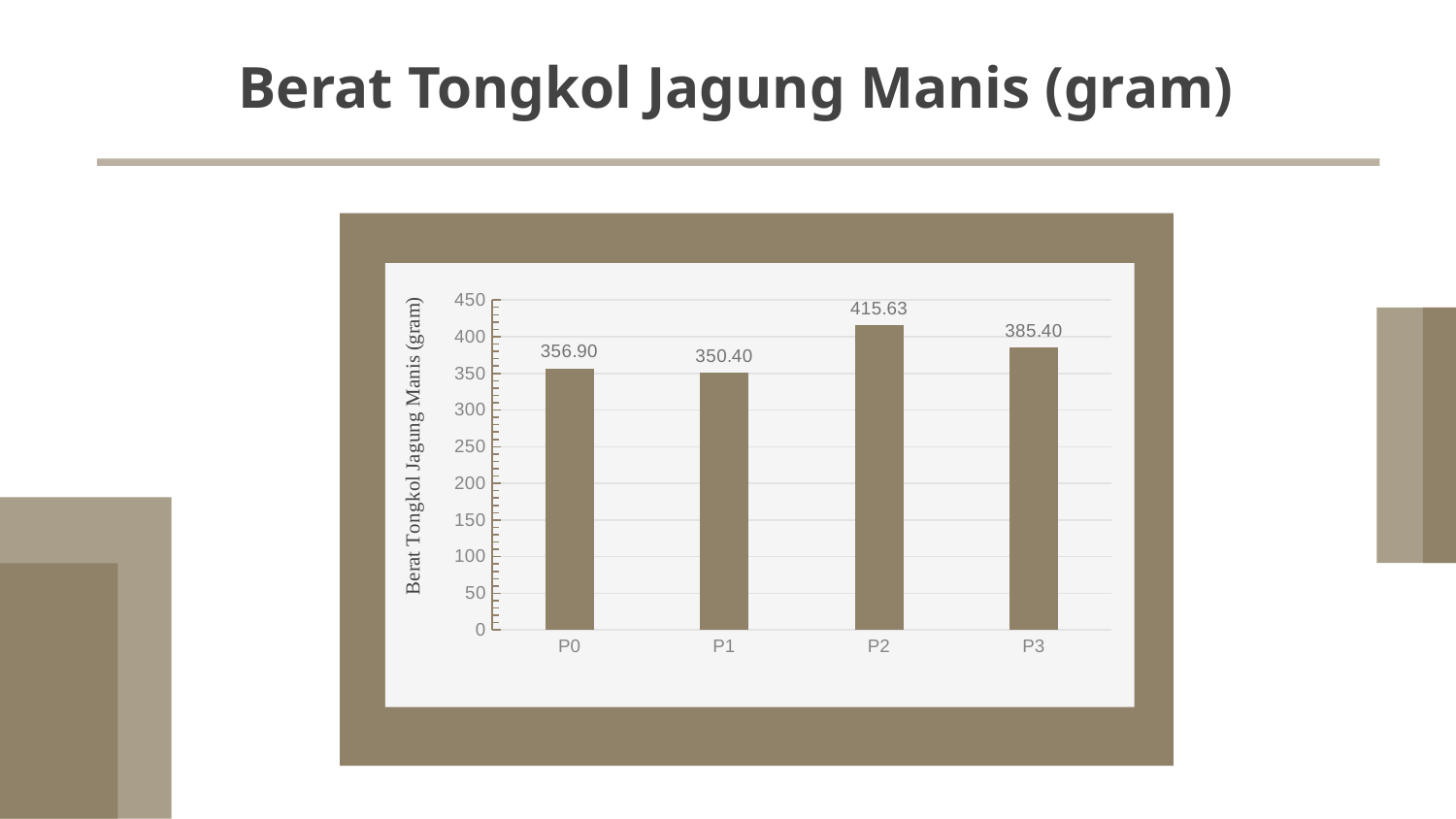
What is the value for P3? 385.40 What kind of chart is shown on the slide? bar chart What is the label of the vertical axis? Berat Tongkol Jagung Manis (gram) Which is larger, the value for P0 or the value for P3? P3 What is the value for P2? 415.63 Which category has the lowest value? P1 What is the difference between the values for P3 and P0? 28.50 Which category has the highest value? P2 What is the difference between the values for P2 and P1? 65.23 How many categories are shown on the x axis? 4 Is the value for P2 greater or less than 400? greater What is the value for P0? 356.90